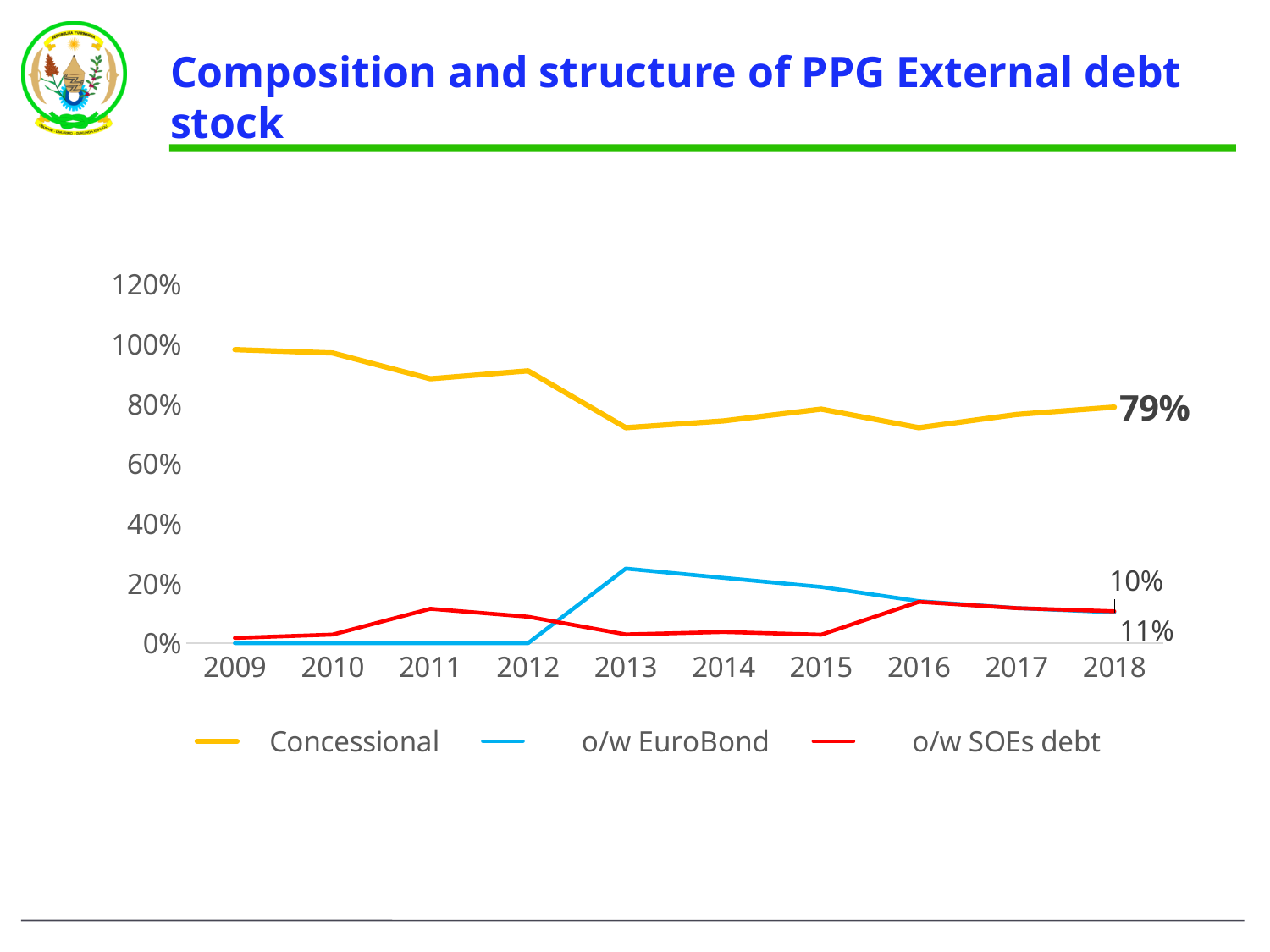
In 2013, which is larger: o/w EuroBond or o/w SOEs debt? o/w EuroBond What colour is the Concessional line? Yellow How many series does the legend list? 3 What is the value of the Concessional series in 2018? 79% How many years are shown on the x axis? 10 Is the value for Concessional in 2013 greater or less than 80%? less What kind of chart is shown on the slide? Line chart Is the value for o/w EuroBond in 2013 greater or less than 20%? greater Is the value for o/w SOEs debt in 2011 greater or less than 20%? less Does the o/w EuroBond series rise or fall from 2013 to 2016? Fall Does the Concessional series rise or fall from 2009 to 2013? Fall